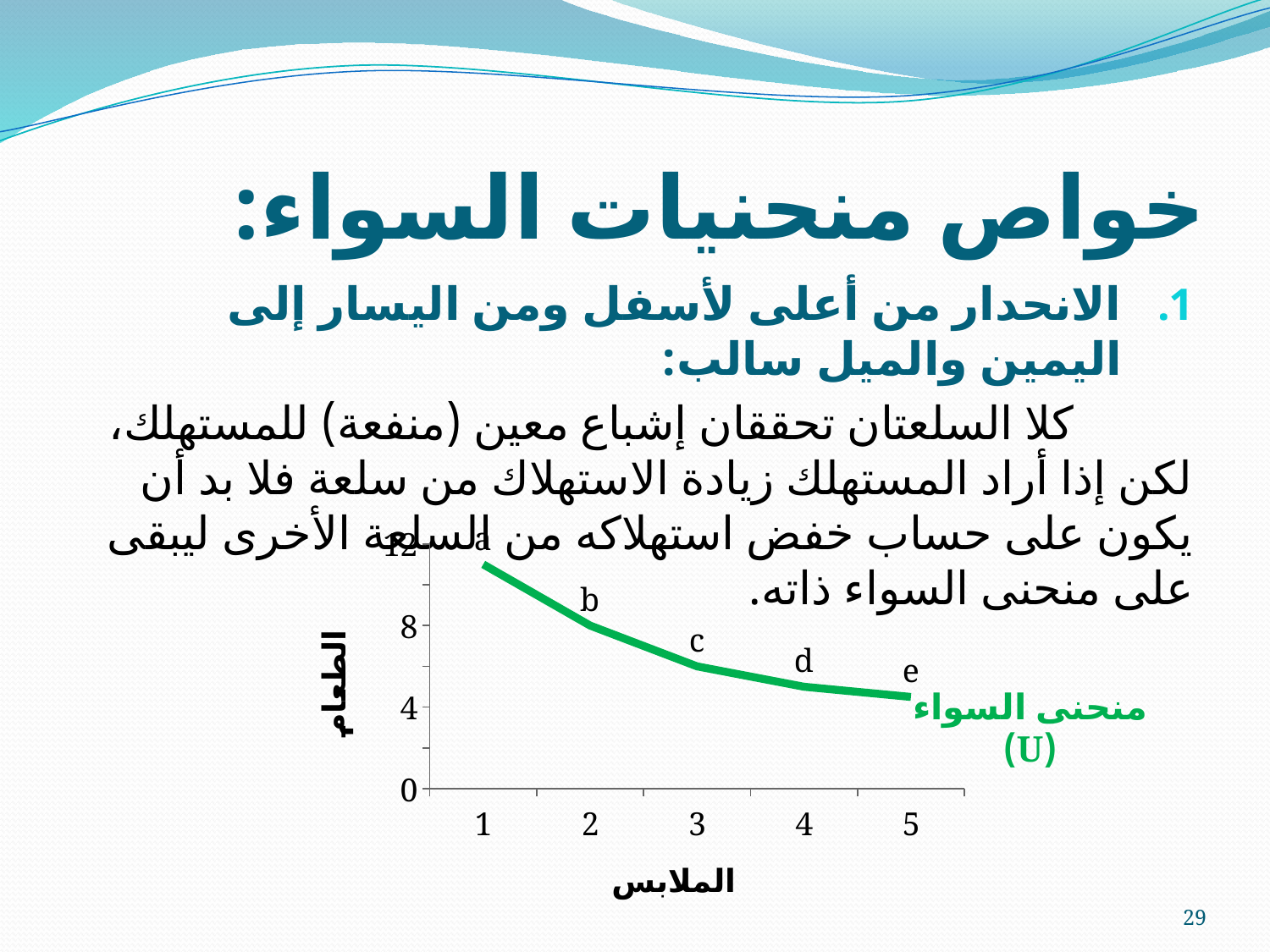
Is the value for point a greater or less than 8? greater How many labelled points are plotted on the curve? 5 Is the value for point c greater or less than 4? greater Do the values rise or fall as you move from left to right along the x axis? fall Which labelled point has the lowest value on the vertical axis? e Which point has a larger value, b or d? b Which labelled point has the highest value on the vertical axis? a What kind of chart is shown on the slide? line chart Is the value for point d greater or less than 8? less What is the label of the vertical axis? الطعام What is the label of the horizontal axis? الملابس